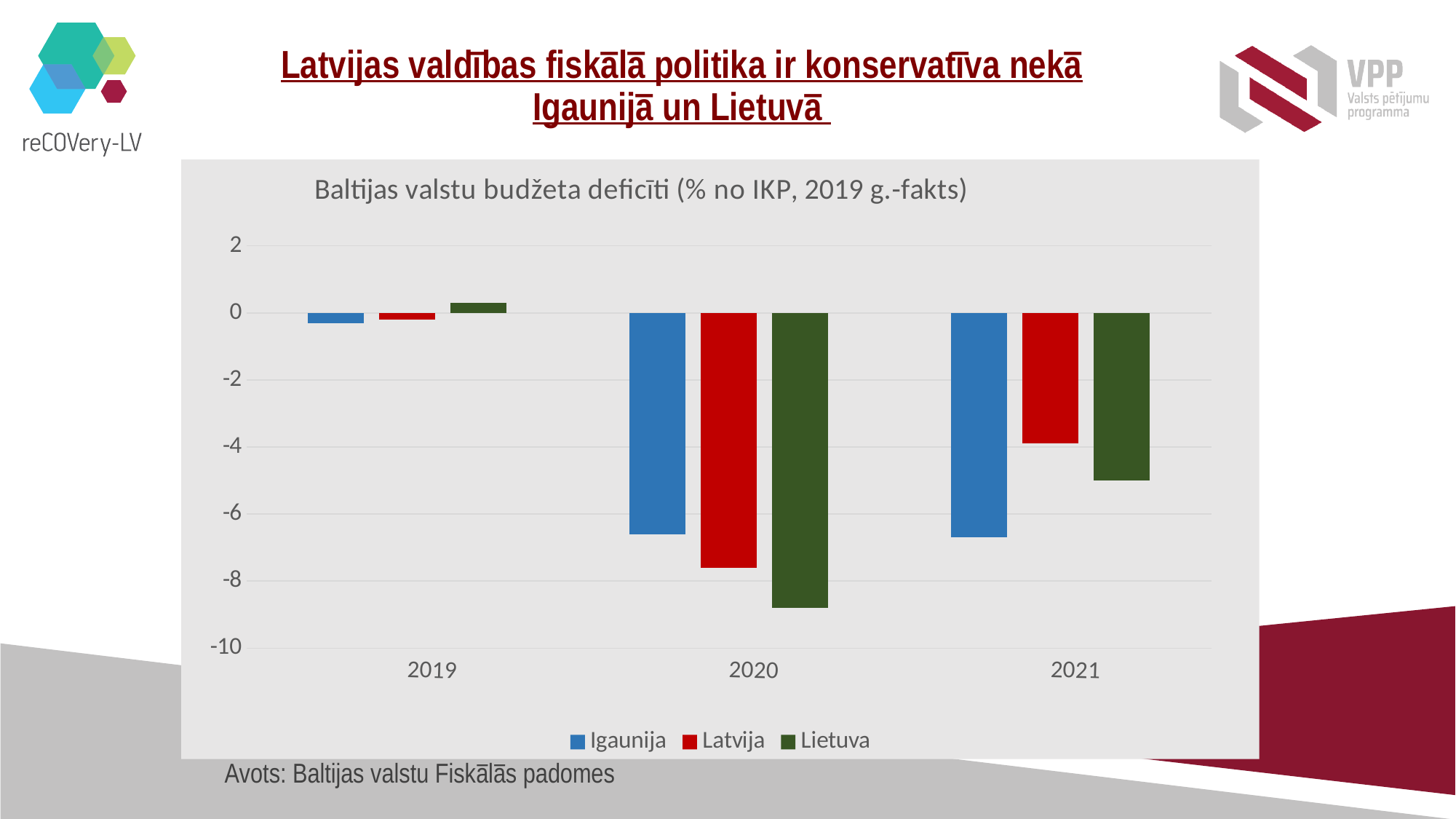
Which is larger, the value for Latvija in 2020 or the value for Lietuva in 2020? Latvija in 2020 Is the value for Igaunija in 2020 greater or less than -6? less Is the value for Lietuva in 2020 greater or less than -8? less Is the value for Latvija in 2021 greater or less than -6? greater Which series is shown in red? Latvija What kind of chart is shown on the slide? bar chart How many years are shown on the x axis? 3 How many series does the legend list? 3 What is the title of the chart? Baltijas valstu budžeta deficīti (% no IKP, 2019 g.-fakts) Which country has the highest value (smallest deficit) in 2021? Latvija Which country has the lowest value (largest deficit) in 2020? Lietuva